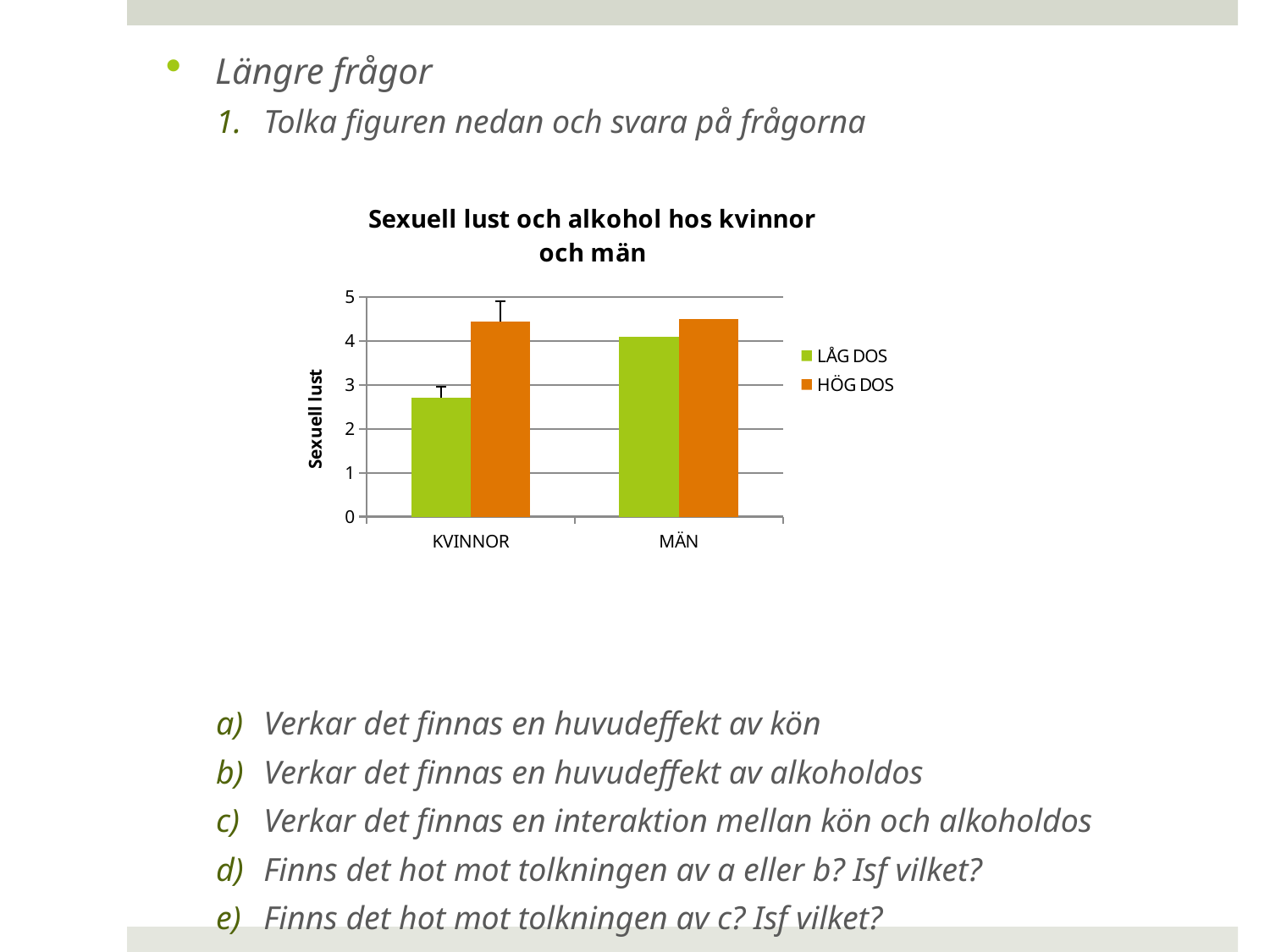
For the LÅG DOS series, which category has the larger value: KVINNOR or MÄN? MÄN How many categories are shown on the x axis? 2 How many series does the legend list? 2 What kind of chart is shown on the slide? bar chart Which bar in the chart is the lowest? LÅG DOS for KVINNOR What is the title of the chart? Sexuell lust och alkohol hos kvinnor och män What is the label of the vertical axis? Sexuell lust Is the LÅG DOS value for MÄN greater or less than 3? greater Is the LÅG DOS value for KVINNOR greater or less than 3? less Is the HÖG DOS value for MÄN greater or less than 4? greater For KVINNOR, which is larger: LÅG DOS or HÖG DOS? HÖG DOS